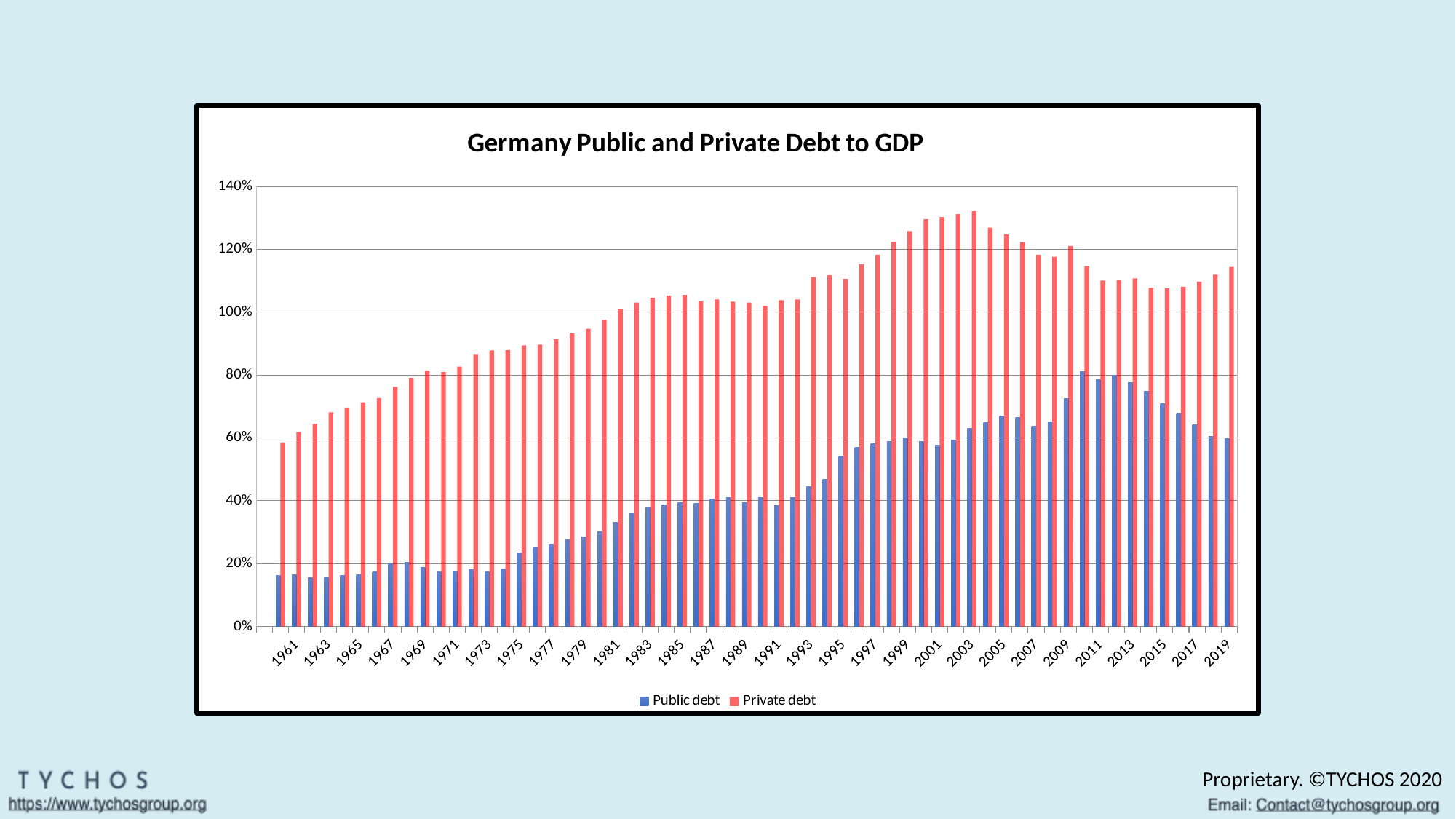
Which colour represents Private debt in the chart? red Which series has the higher value in 2019, Public debt or Private debt? Private debt Is the Private debt value for 1979 greater or less than 100%? less What is the title of the chart? Germany Public and Private Debt to GDP Is the Private debt value for 2003 greater or less than 120%? greater How many series does the legend list? 2 Is the Public debt value for 1961 greater or less than 20%? less Which year has the highest Private debt value? 2003 Does Private debt rise or fall from 1961 to 1985? rise What kind of chart is shown on the slide? bar chart